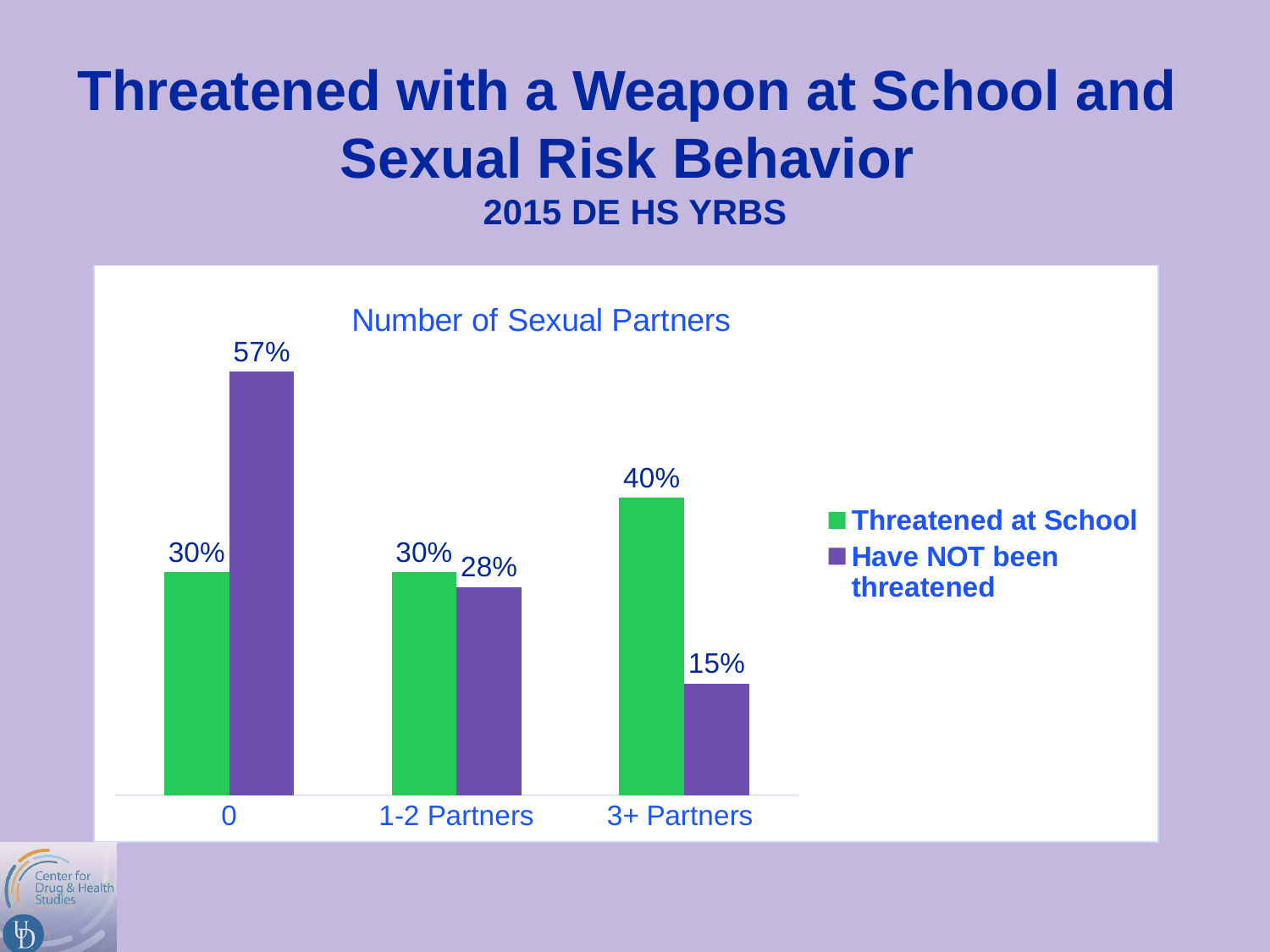
What is the value for 'Have NOT been threatened' in the 1-2 Partners category? 28% What percentage of students threatened at school reported 3+ partners? 40% Which category has the highest value for the 'Have NOT been threatened' series? 0 In the 3+ Partners category, which series has the larger value? Threatened at School Which category has the lowest value for the 'Have NOT been threatened' series? 3+ Partners What is the difference between the 'Have NOT been threatened' and 'Threatened at School' values in the 0 partners category? 27% What kind of chart is shown on the slide? Bar chart How many series does the legend list? 2 What is the title of the chart? Number of Sexual Partners What percentage of students who have NOT been threatened reported 0 sexual partners? 57% What is the difference between the 'Threatened at School' and 'Have NOT been threatened' values for 3+ Partners? 25% How many categories are shown on the x axis? 3